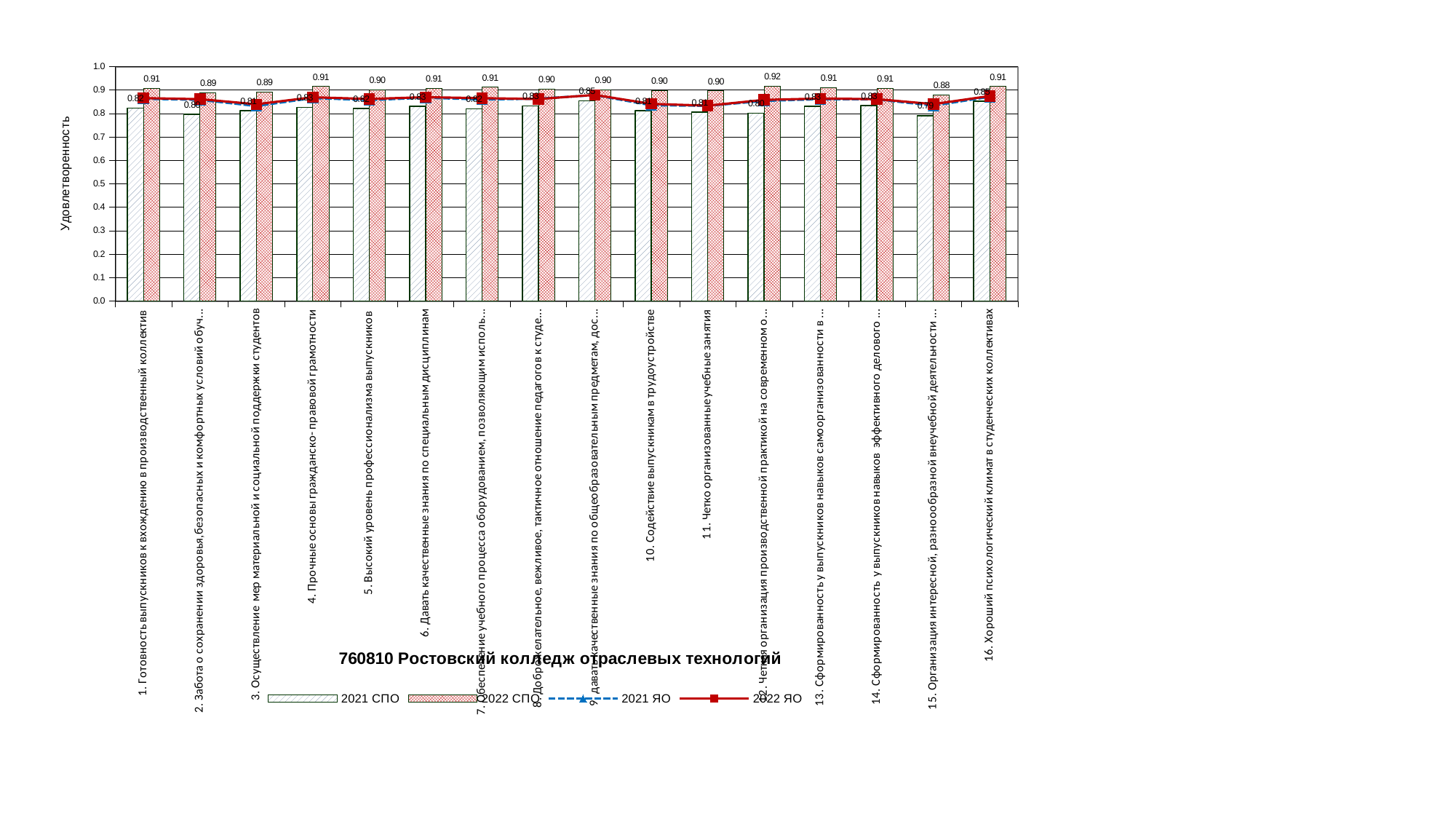
How many series does the chart legend list? 4 What is the title of the chart? 760810 Ростовский колледж отраслевых технологий What kind of chart is shown on the slide? bar chart with line series What is the 2022 СПО value for category "10. Содействие выпускникам в трудоустройстве"? 0.90 Which numbered category has the highest 2022 СПО value? 12 How many categories are shown on the x axis of the chart? 16 What is the difference between the 2022 СПО values for category 1 (Готовность выпускников к вхождению в производственный коллектив) and category 3 (Осуществление мер материальной и социальной поддержки студентов)? 0.02 What is the 2022 СПО value for category "1. Готовность выпускников к вхождению в производственный коллектив"? 0.91 What is the 2022 СПО value for category "16. Хороший психологический климат в студенческих коллективах"? 0.91 Which has the larger 2022 СПО value: category "5. Высокий уровень профессионализма выпускников" or category "6. Давать качественные знания по специальным дисциплинам"? 6. Давать качественные знания по специальным дисциплинам Is the 2021 СПО value for category "16. Хороший психологический климат в студенческих коллективах" greater or less than 0.8? greater What is the 2022 СПО value for category "3. Осуществление мер материальной и социальной поддержки студентов"? 0.89